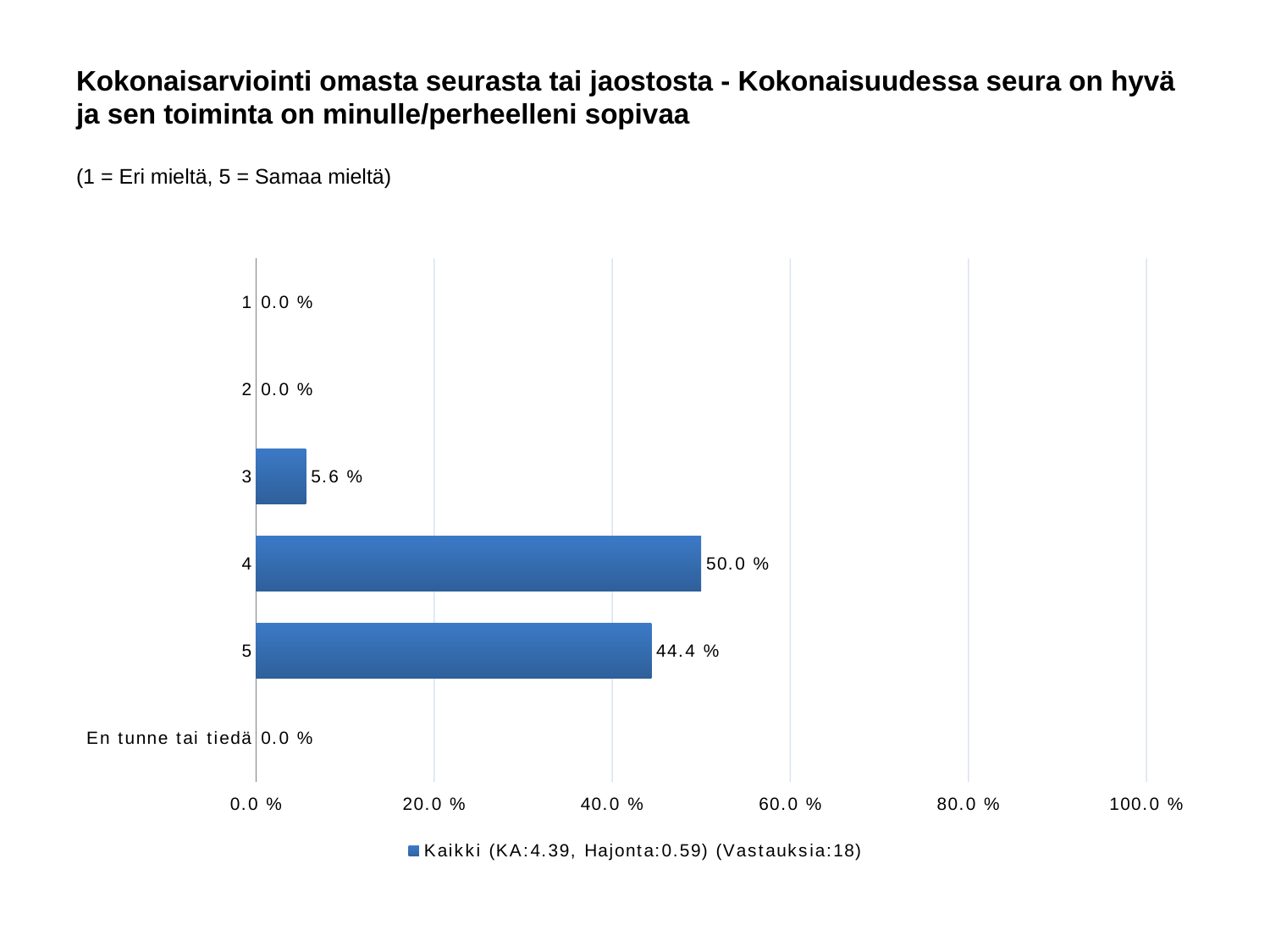
What kind of chart is shown on the slide? bar chart What is the value for category 5? 44.4 % How many categories are shown on the chart? 6 Which is larger, the value for category 3 or the value for category 5? 5 How many series does the legend list? 1 What is the value for category 4? 50.0 % Which category has the highest value? 4 What is the value for the category 'En tunne tai tiedä'? 0.0 % How many responses (Vastauksia) does the legend entry report? 18 Is the value for category 4 greater or less than 40.0 %? greater What is the value for category 3? 5.6 % What is the difference between the values for category 4 and category 5? 5.6 %